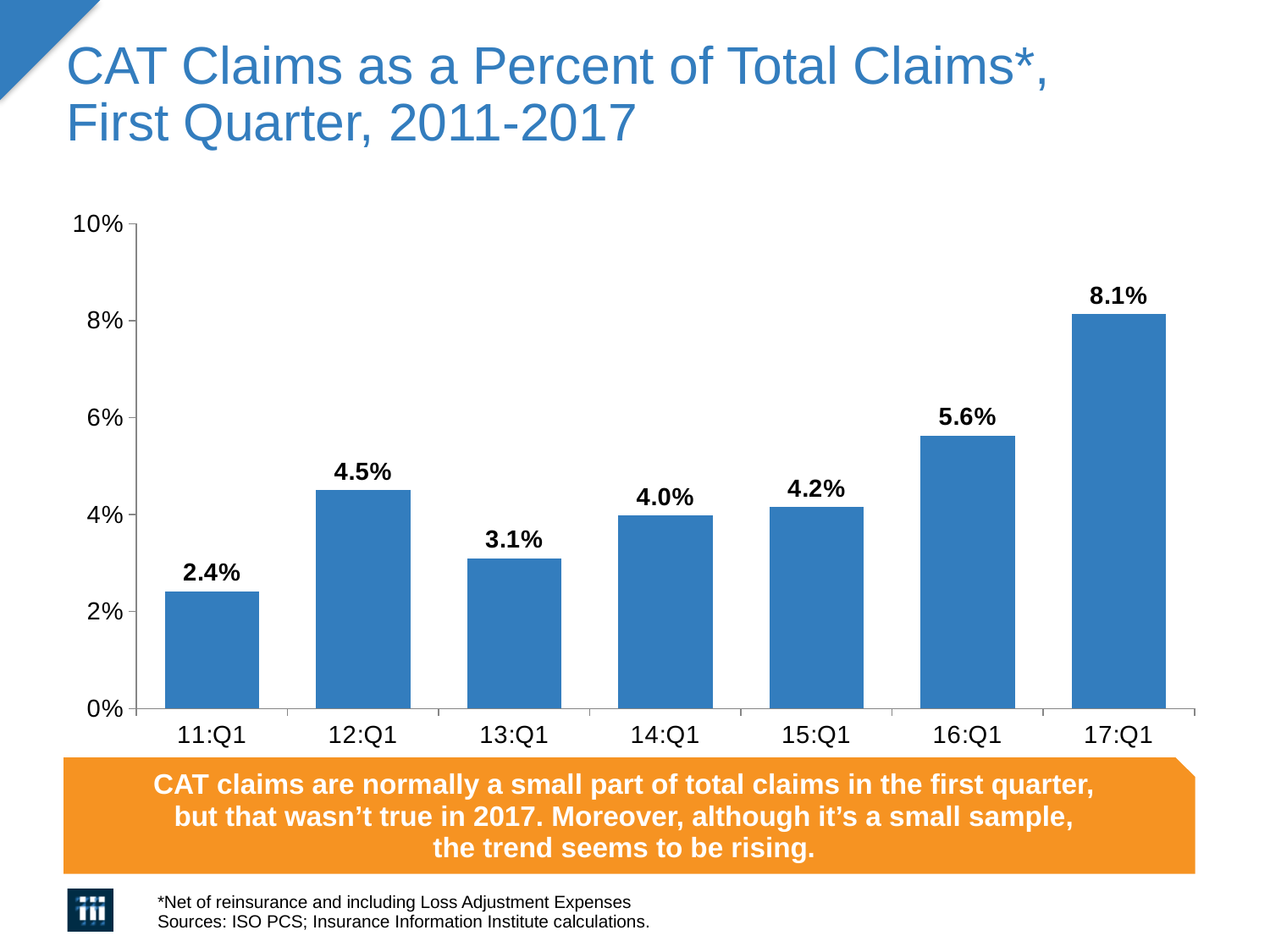
Which quarter has the highest CAT claims percentage? 17:Q1 What is the value for 13:Q1? 3.1% What is the value for 11:Q1? 2.4% Is the value for 16:Q1 greater or less than 6%? less What is the difference between the values for 17:Q1 and 16:Q1? 2.5% What is the title of the chart? CAT Claims as a Percent of Total Claims*, First Quarter, 2011-2017 What kind of chart is shown on the slide? bar chart Which is larger, the value for 12:Q1 or the value for 14:Q1? 12:Q1 How many quarters are shown on the chart? 7 Which quarter has the lowest CAT claims percentage? 11:Q1 What is the value for 17:Q1? 8.1% What is the difference between the values for 12:Q1 and 13:Q1? 1.4%